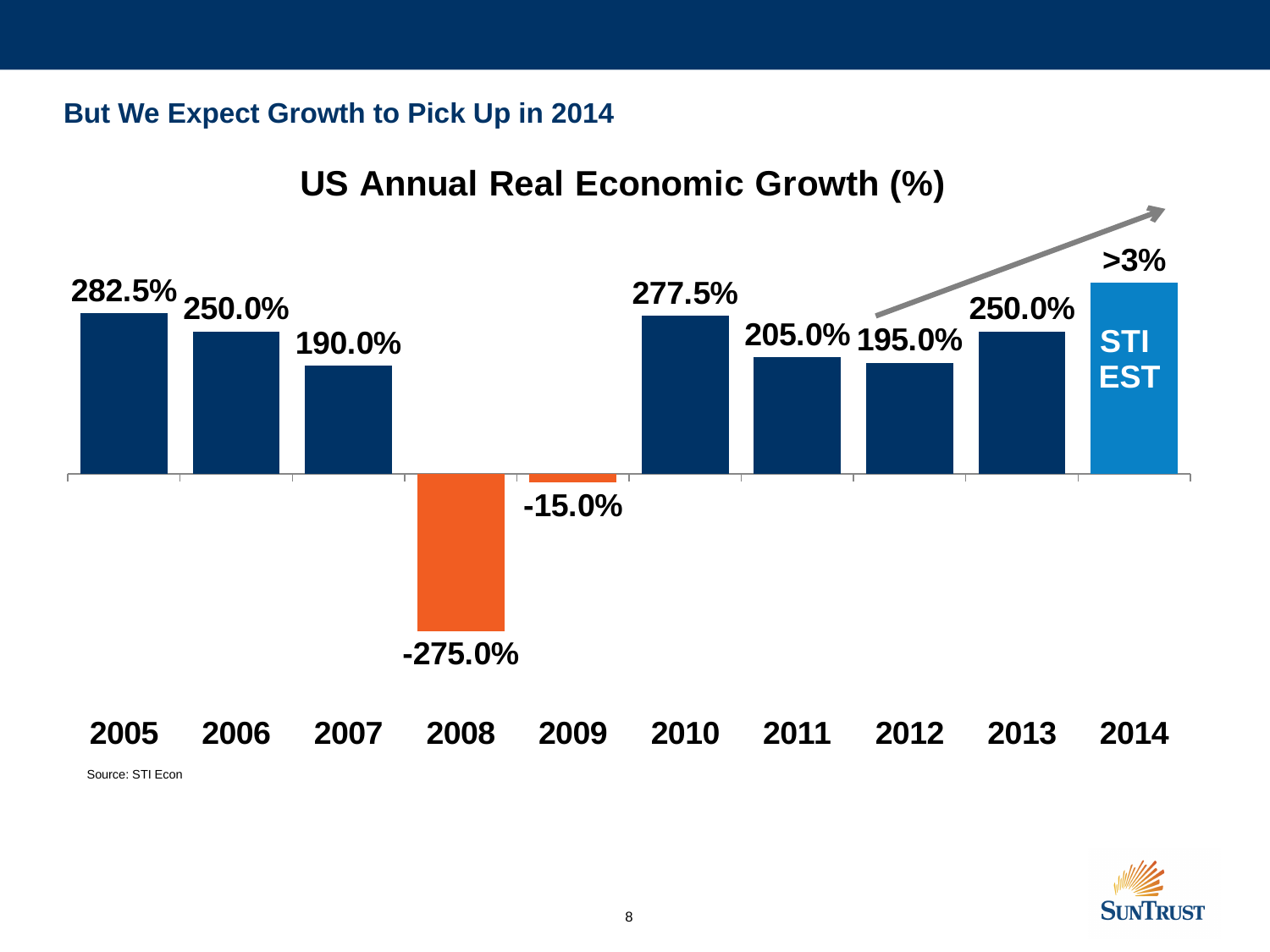
What is the title of the chart? US Annual Real Economic Growth (%) What is the difference between the values for 2010 and 2011? 72.5% What is the value for 2005? 282.5% Which is larger, the value for 2011 or the value for 2012? 2011 How many years are shown on the x axis? 10 What kind of chart is this? Bar chart Do the values rise or fall from 2010 to 2012? Fall What is the value for 2008? -275.0% What is the value shown for 2014? >3% Which year has the lowest value? 2008 What is the value for 2009? -15.0%